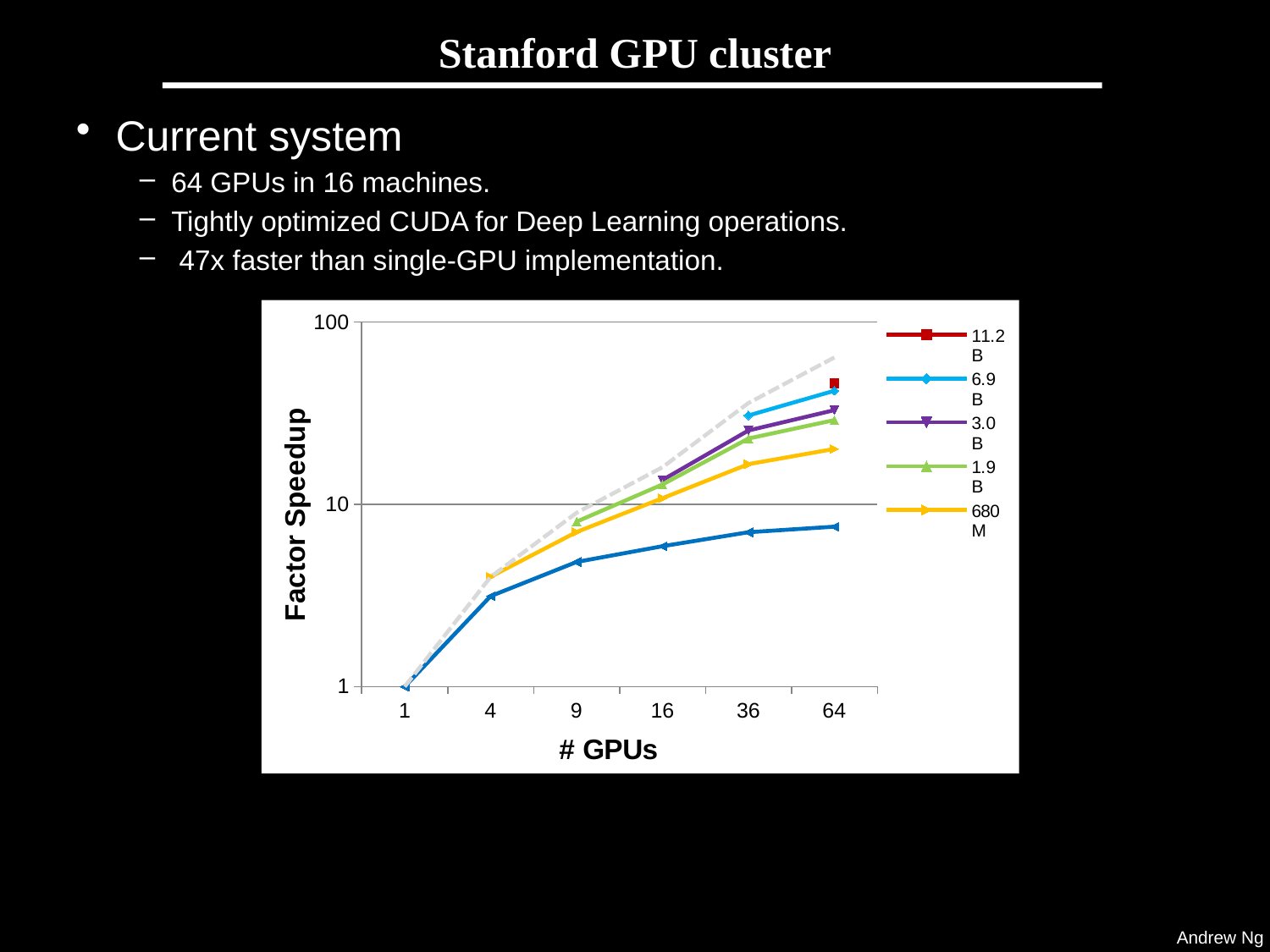
What is the label of the x axis of the chart? # GPUs How many series does the chart legend list? 5 Is the Factor Speedup for the 680 M series at 64 GPUs greater or less than 10? greater Is the Factor Speedup for the 680 M series at 4 GPUs greater or less than 10? less What is the label of the y axis of the chart? Factor Speedup How many # GPUs values are marked on the x axis of the chart? 6 Does the Factor Speedup for the 680 M series rise or fall as the number of GPUs increases? rise Is the Factor Speedup for the 1.9 B series at 36 GPUs greater or less than 10? greater What kind of chart is shown on the slide? line chart At 64 GPUs, which series has the higher Factor Speedup, 6.9 B or 680 M? 6.9 B Among the series listed in the legend, which has the highest Factor Speedup at 64 GPUs? 11.2 B